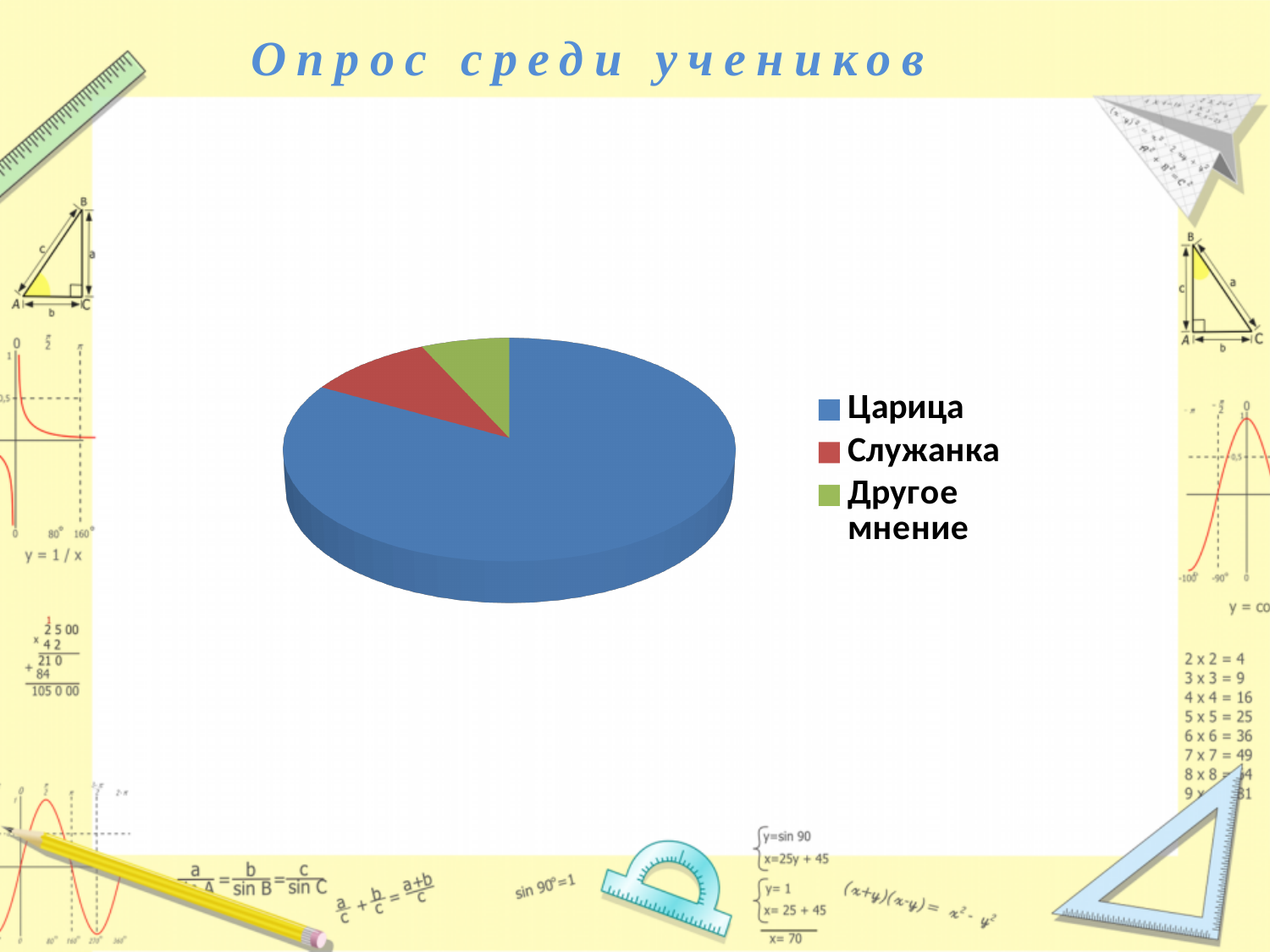
How many entries does the legend of the pie chart list? 3 What is the title of the slide containing the pie chart? Опрос среди учеников What kind of chart is shown on the slide? pie chart Which slice is larger, Царица or Служанка? Царица How many slices does the pie chart have? 3 Which category has the largest slice of the pie chart? Царица What colour is the Царица slice in the pie chart? blue Which slice is larger, Царица or Другое мнение? Царица